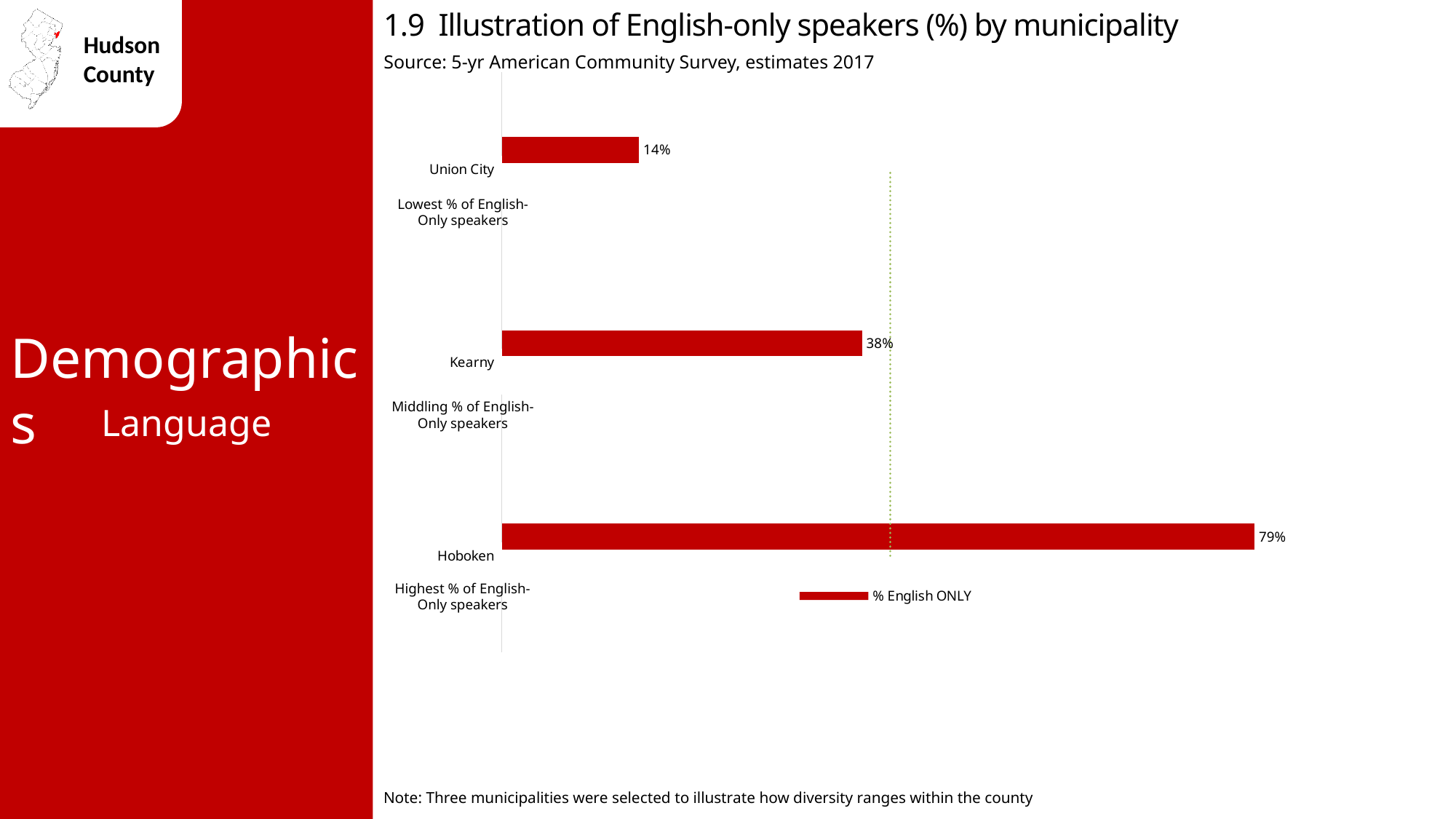
What is the difference in percentage points between Kearny and Union City? 24 What is the difference in percentage points between Hoboken and Union City? 65 Which municipality has the lowest percentage of English-only speakers? Union City What kind of chart is shown on the slide? Bar chart Which has a higher percentage of English-only speakers, Kearny or Union City? Kearny What is the percentage of English-only speakers in Hoboken? 79% What is the percentage of English-only speakers in Kearny? 38% How many municipalities are shown in the chart? 3 What is the legend entry for the series in the chart? % English ONLY Which municipality has the highest percentage of English-only speakers? Hoboken What is the percentage of English-only speakers in Union City? 14% How many series does the legend list? 1